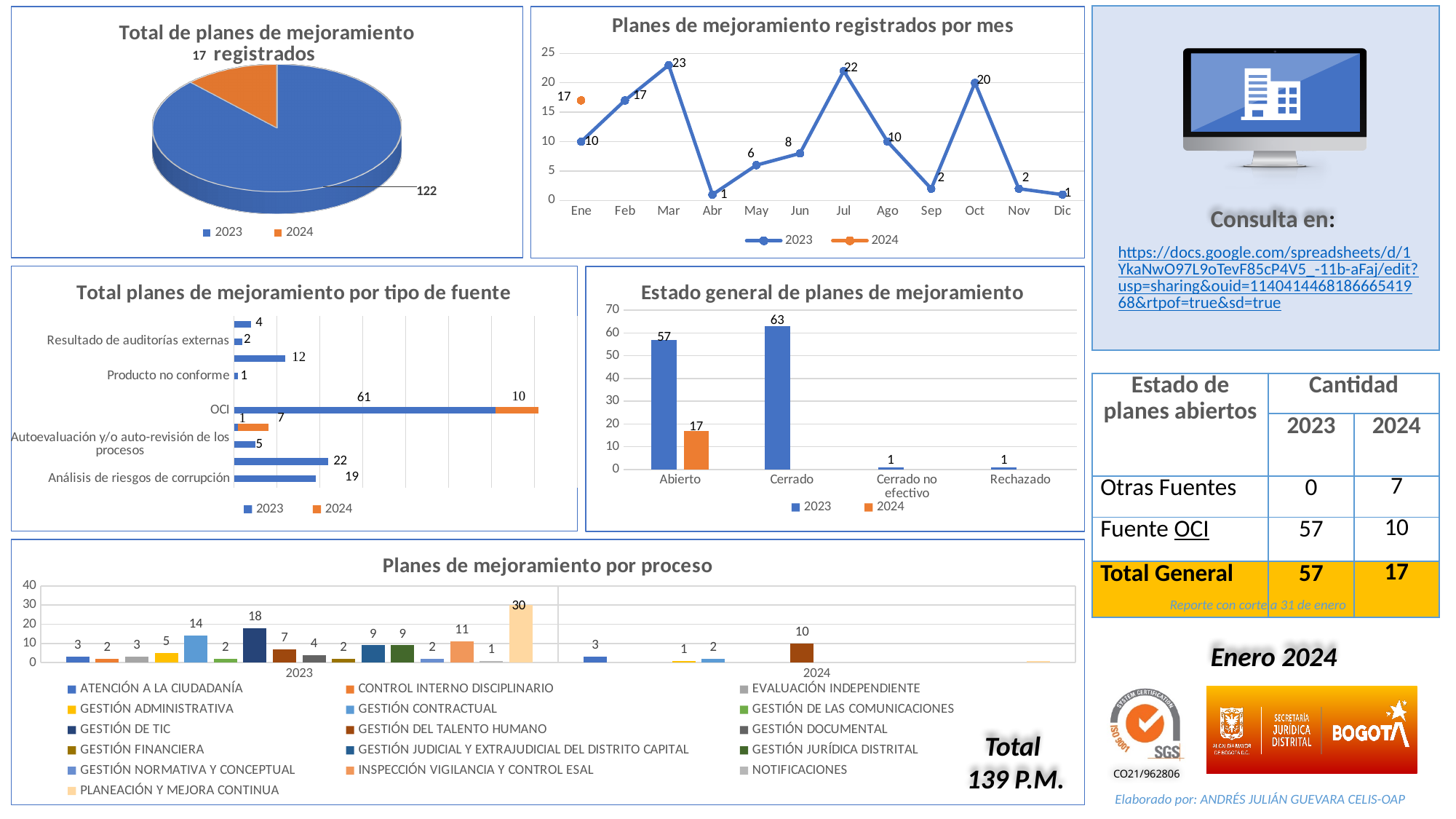
What type of chart is 'Estado general de planes de mejoramiento'? Bar chart In the line chart 'Planes de mejoramiento registrados por mes', which month has the highest value for 2023? Mar In the chart 'Total planes de mejoramiento por tipo de fuente', what is the 2024 value for OCI? 10 In the line chart 'Planes de mejoramiento registrados por mes', how many months are shown on the x axis? 12 In the pie chart 'Total de planes de mejoramiento registrados', what is the value for 2023? 122 In the chart 'Planes de mejoramiento por proceso', which process has the highest value for 2023? PLANEACIÓN Y MEJORA CONTINUA In the chart 'Estado general de planes de mejoramiento', what is the 2023 value for Cerrado? 63 In the chart 'Total planes de mejoramiento por tipo de fuente', what is the 2023 value for OCI? 61 In the pie chart 'Total de planes de mejoramiento registrados', what is the value for 2024? 17 In the line chart 'Planes de mejoramiento registrados por mes', what is the difference between the 2023 values for Oct and Sep? 18 In the line chart 'Planes de mejoramiento registrados por mes', what is the 2023 value for Jul? 22 In the chart 'Estado general de planes de mejoramiento', which is larger for 2023: Abierto or Cerrado? Cerrado